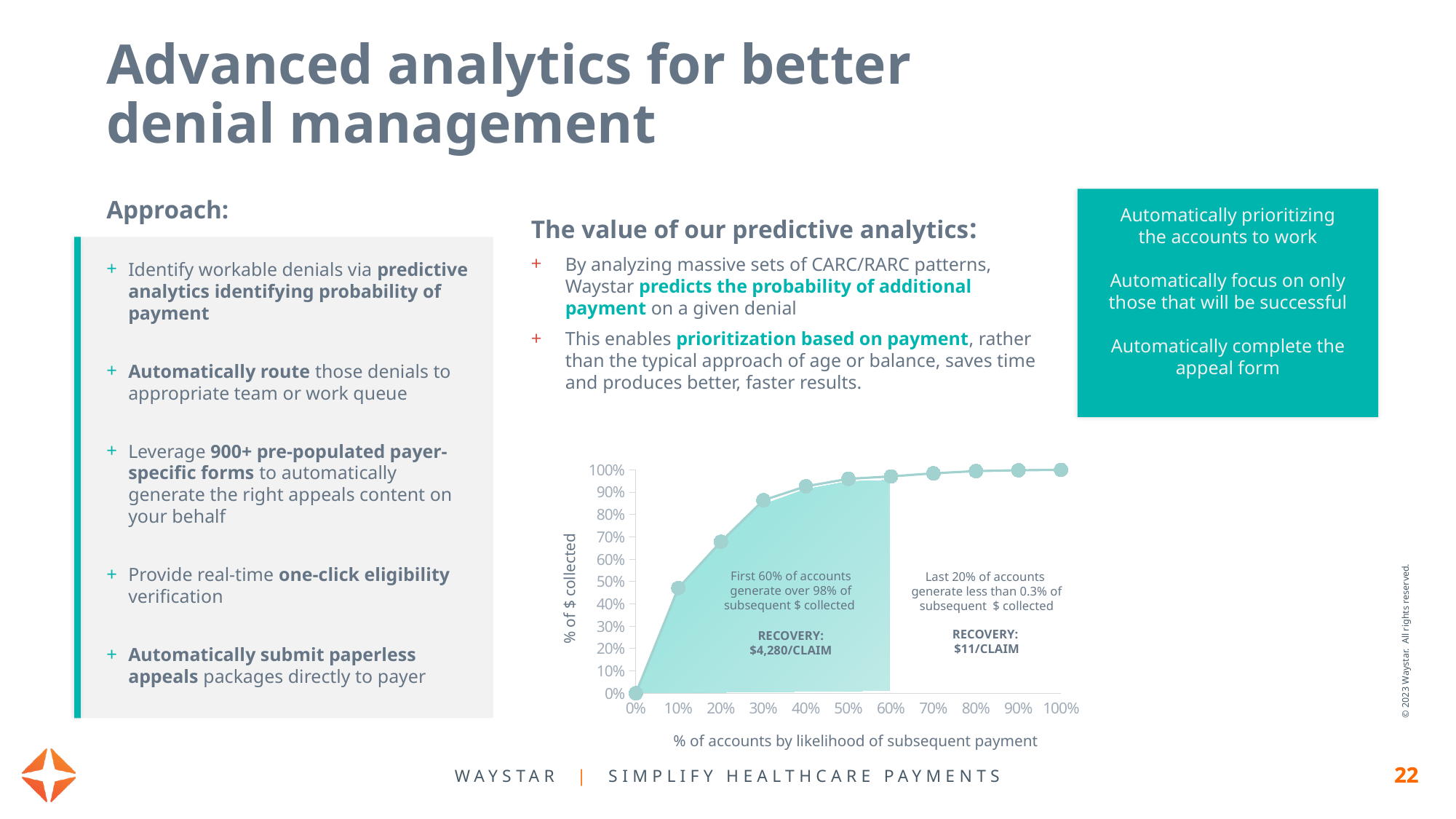
What is the % of $ collected at 0% of accounts? 0% Is the % of $ collected at 10% of accounts greater or less than 40%? greater What is the label of the y axis of the chart? % of $ collected Is the % of $ collected at 30% of accounts greater or less than 80%? greater How many data points are plotted on the line in the chart? 11 What is the label of the x axis of the chart? % of accounts by likelihood of subsequent payment According to the chart annotation, what is the recovery per claim for the first 60% of accounts? $4,280/CLAIM Do the values on the chart rise or fall as the x axis moves from 0% to 100%? rise Is the % of $ collected at 20% of accounts greater or less than 70%? less What kind of chart is shown on the slide? line chart According to the chart annotation, what is the recovery per claim for the last 20% of accounts? $11/CLAIM What is the % of $ collected at 100% of accounts? 100%